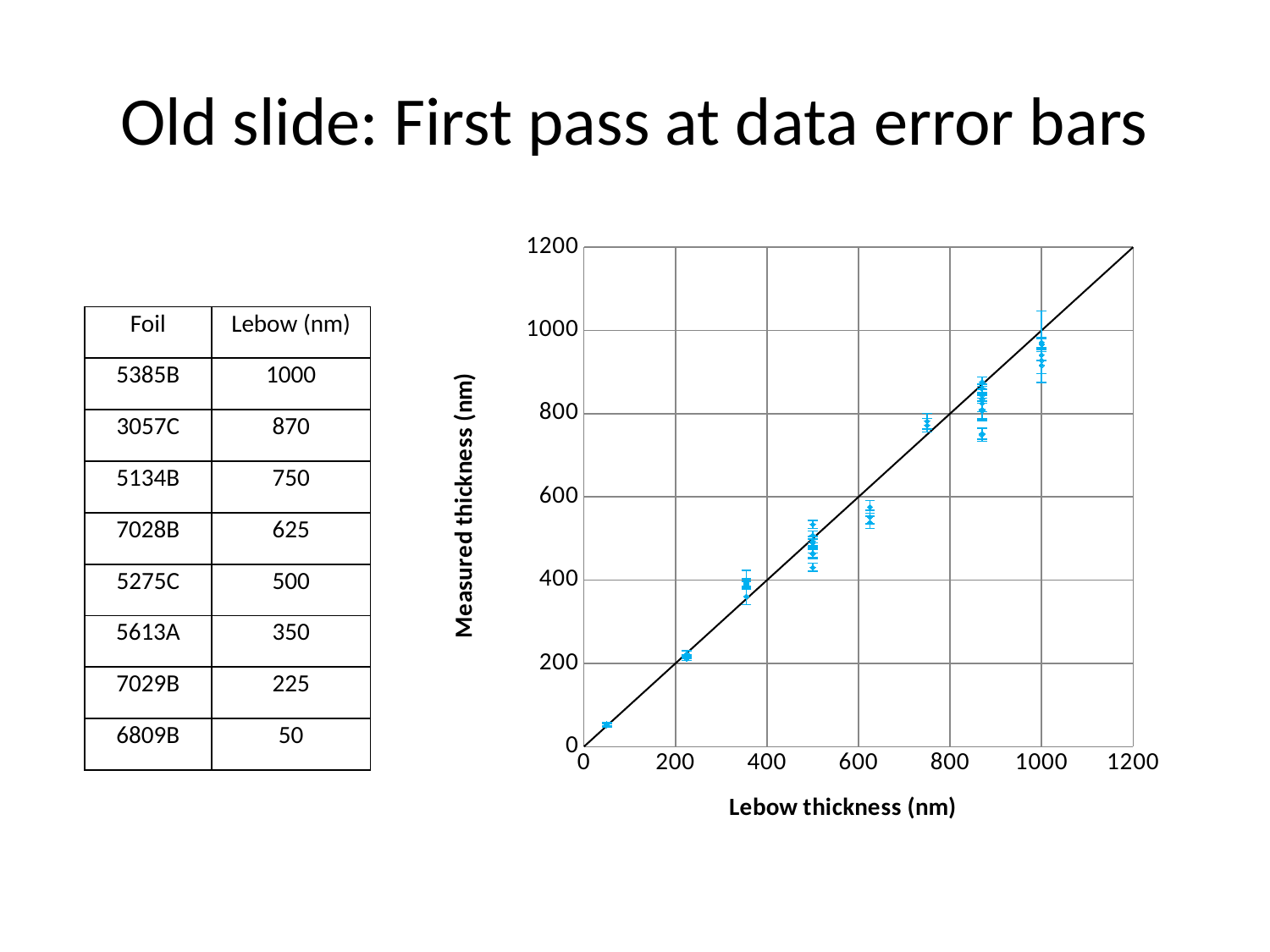
Is the measured thickness for the points at Lebow thickness 750 nm greater or less than 600? greater What is the maximum value shown on the chart's y axis? 1200 Which has higher measured thickness on the chart: the points at Lebow thickness 225 nm or the points at Lebow thickness 750 nm? 750 nm What is the title of the chart's x axis? Lebow thickness (nm) What kind of chart is shown on the slide? scatter chart Is the measured thickness for the points at Lebow thickness 870 nm greater or less than 600? greater Is the measured thickness for the points at Lebow thickness 500 nm greater or less than 800? less What is the title of the chart's y axis? Measured thickness (nm) Do the measured thickness values rise or fall as Lebow thickness increases along the x axis? rise How many distinct Lebow thickness positions have data points plotted on the chart? 8